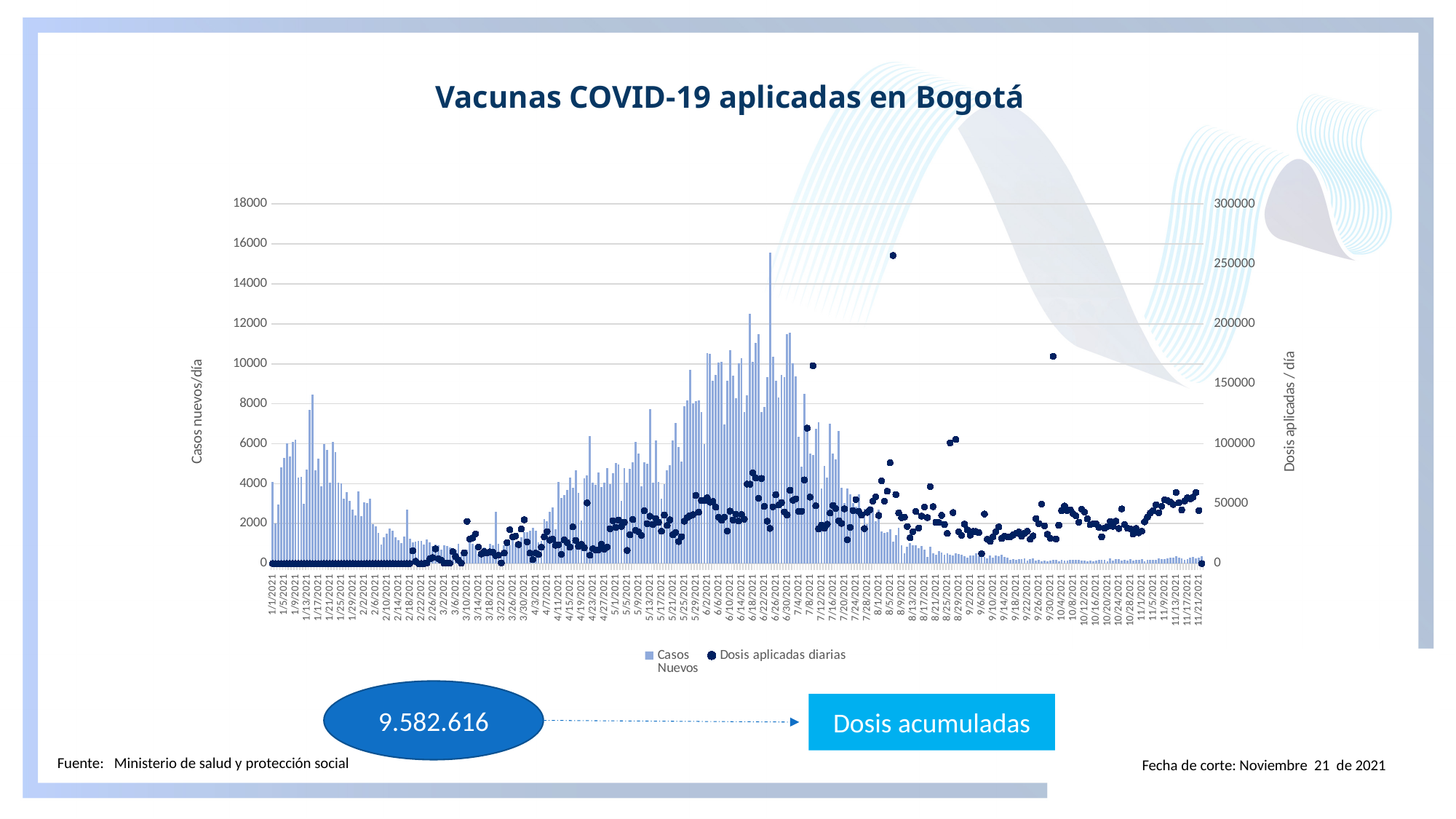
Is the highest Dosis aplicadas diarias point greater or less than 200000? greater Is the Dosis aplicadas diarias point near 9/30/2021 greater or less than 150000? greater Is the Casos Nuevos value on 1/1/2021 greater or less than 6000? less What is the label of the left vertical axis? Casos nuevos/día Near which date label does the highest Dosis aplicadas diarias point appear? 8/5/2021 What kind of chart is used to plot the Casos Nuevos series? bar chart What is the highest tick value shown on the right vertical axis (Dosis aplicadas / día)? 300000 How many series does the chart legend list? 2 What is the title of the chart? Vacunas COVID-19 aplicadas en Bogotá Do the Casos Nuevos values rise or fall from late June 2021 to November 2021? fall